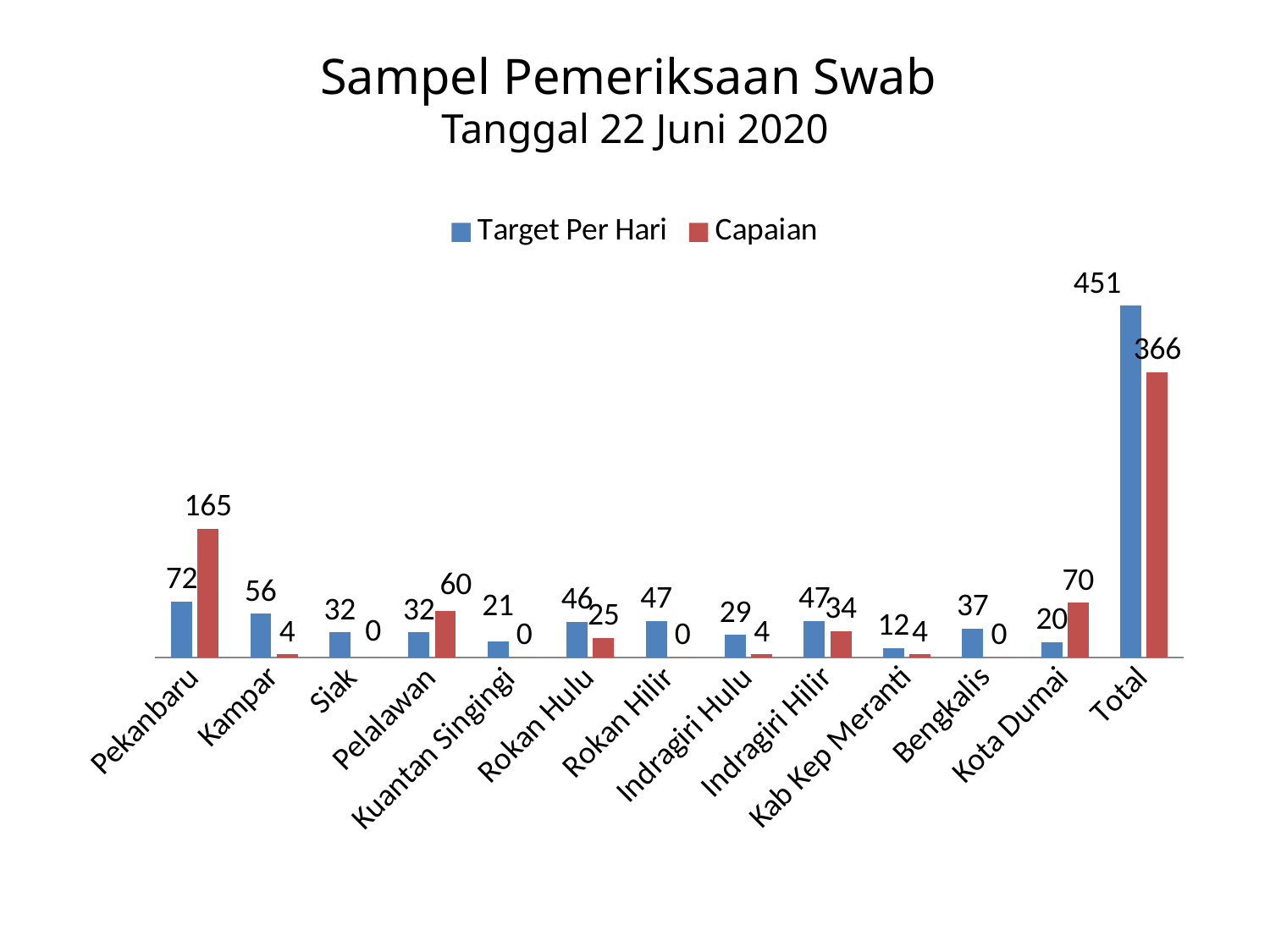
For Pekanbaru, how much larger is Capaian than Target Per Hari? 93 How many series does the legend list? 2 Excluding the Total bar, which category has the highest Capaian value? Pekanbaru What kind of chart is shown on the slide? Bar chart What is the Capaian value for Kota Dumai? 70 Which category has the lowest Target Per Hari value? Kab Kep Meranti For the Total category, how much larger is Target Per Hari than Capaian? 85 What is the Target Per Hari value for Kampar? 56 What date is given in the chart title? 22 Juni 2020 How many categories are shown on the x axis? 13 For Pelalawan, which is larger: Target Per Hari or Capaian? Capaian What is the Capaian value for Pekanbaru? 165